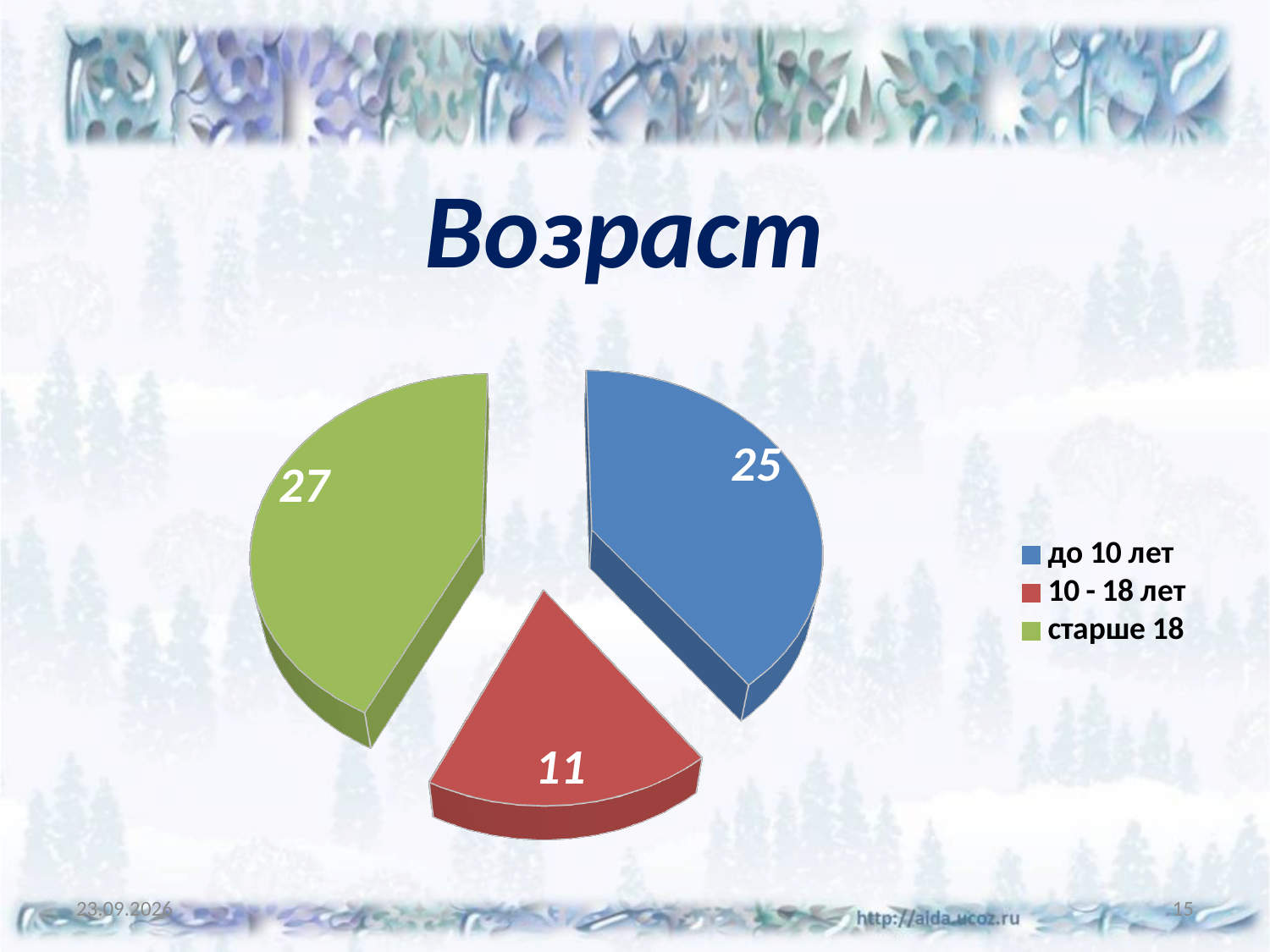
What is the value for the category 'старше 18'? 27 Which category has the largest slice of the pie? старше 18 Which category has the smallest slice of the pie? 10 - 18 лет How many categories does the pie chart have? 3 What is the difference between the values for 'старше 18' and '10 - 18 лет'? 16 What is the difference between the values for 'до 10 лет' and '10 - 18 лет'? 14 What type of chart is shown on the slide? pie chart Which is larger, the value for 'до 10 лет' or the value for '10 - 18 лет'? до 10 лет What is the value for the category 'до 10 лет'? 25 What is the title of the chart? Возраст What colour is the slice for '10 - 18 лет'? red What is the value for the category '10 - 18 лет'? 11